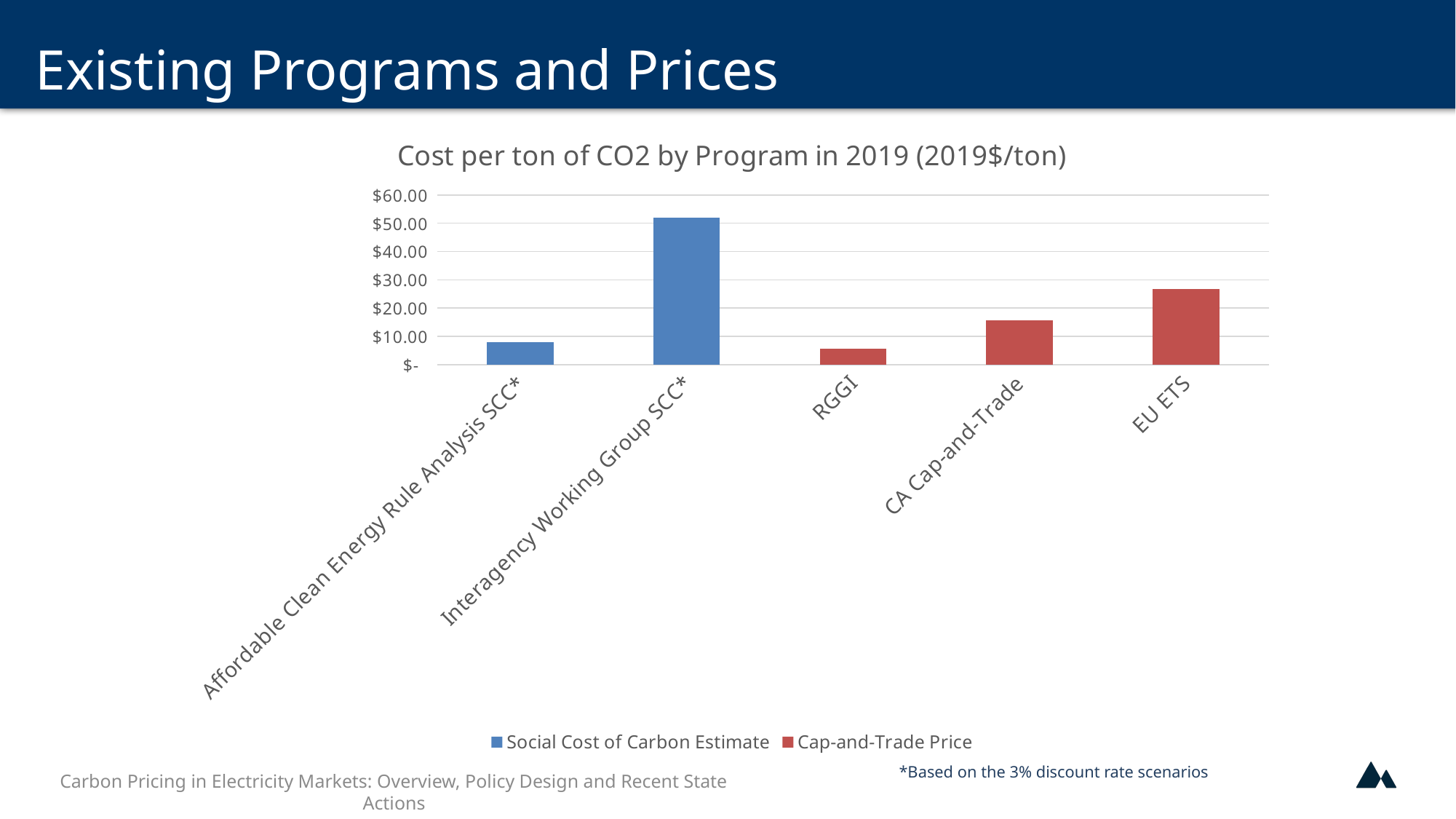
Is the value for RGGI greater or less than $10.00? less Is the value for Interagency Working Group SCC* greater or less than $50.00? greater What kind of chart is shown on the slide? bar chart Is the value for Affordable Clean Energy Rule Analysis SCC* greater or less than $10.00? less Which legend series is shown in red? Cap-and-Trade Price Which is larger, the value for CA Cap-and-Trade or the value for EU ETS? EU ETS What is the title of the chart? Cost per ton of CO2 by Program in 2019 (2019$/ton) Which program has the highest cost per ton of CO2? Interagency Working Group SCC* Which program has the lowest cost per ton of CO2? RGGI How many programs (categories) are shown on the x axis? 5 How many series does the legend list? 2